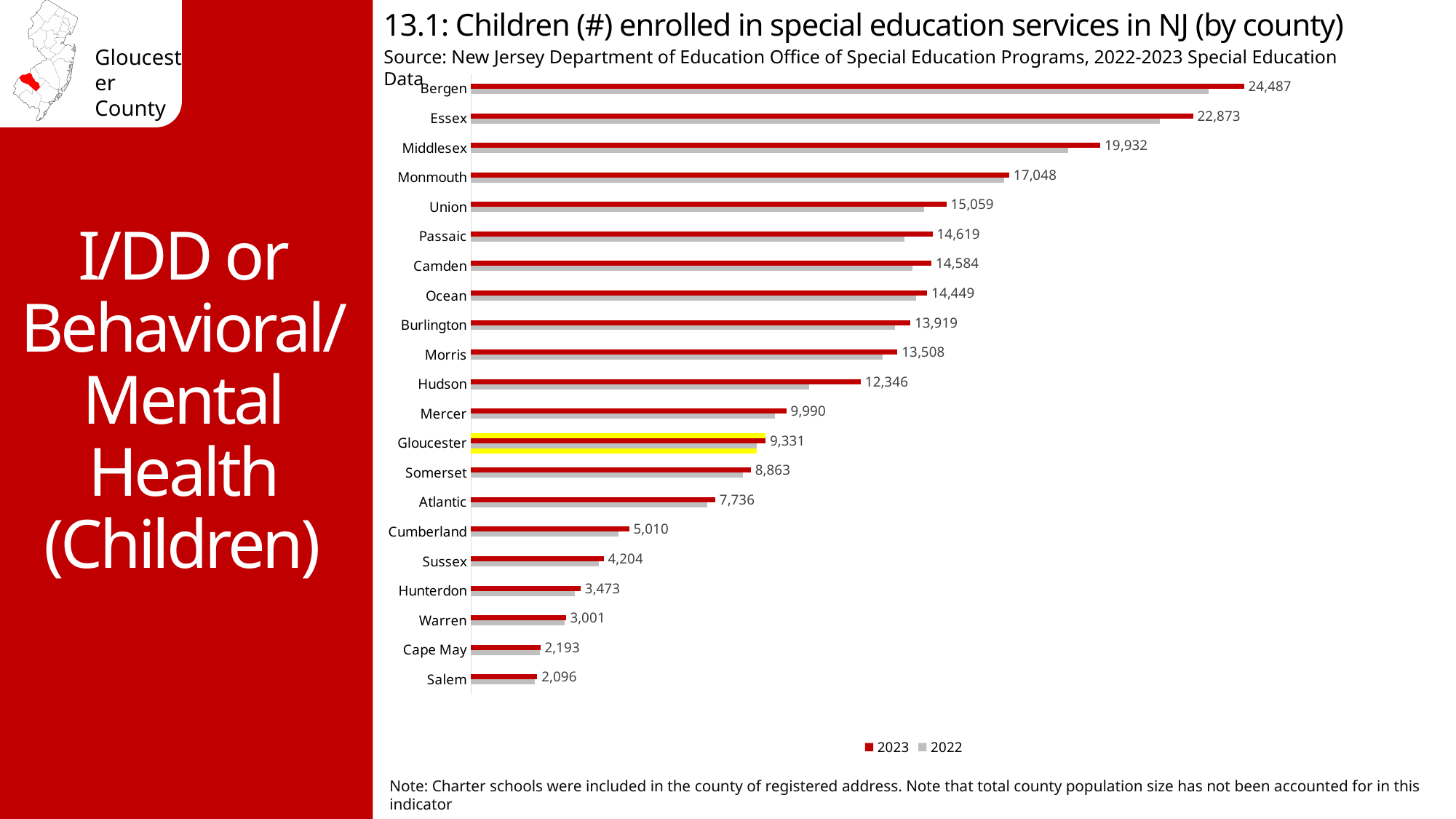
What is the 2023 value for Cumberland? 5,010 What is the difference between the 2023 values for Gloucester and Somerset? 468 Which has a larger 2023 value, Hudson or Mercer? Hudson What is the 2023 value for Gloucester? 9,331 What kind of chart is shown? Bar chart What is the 2023 value for Bergen? 24,487 Which county's bars are highlighted in yellow? Gloucester How many series does the legend list? 2 Which county has the highest 2023 value? Bergen What is the difference between the 2023 values for Bergen and Essex? 1,614 How many counties are shown in the chart? 21 Which county has the lowest 2023 value? Salem